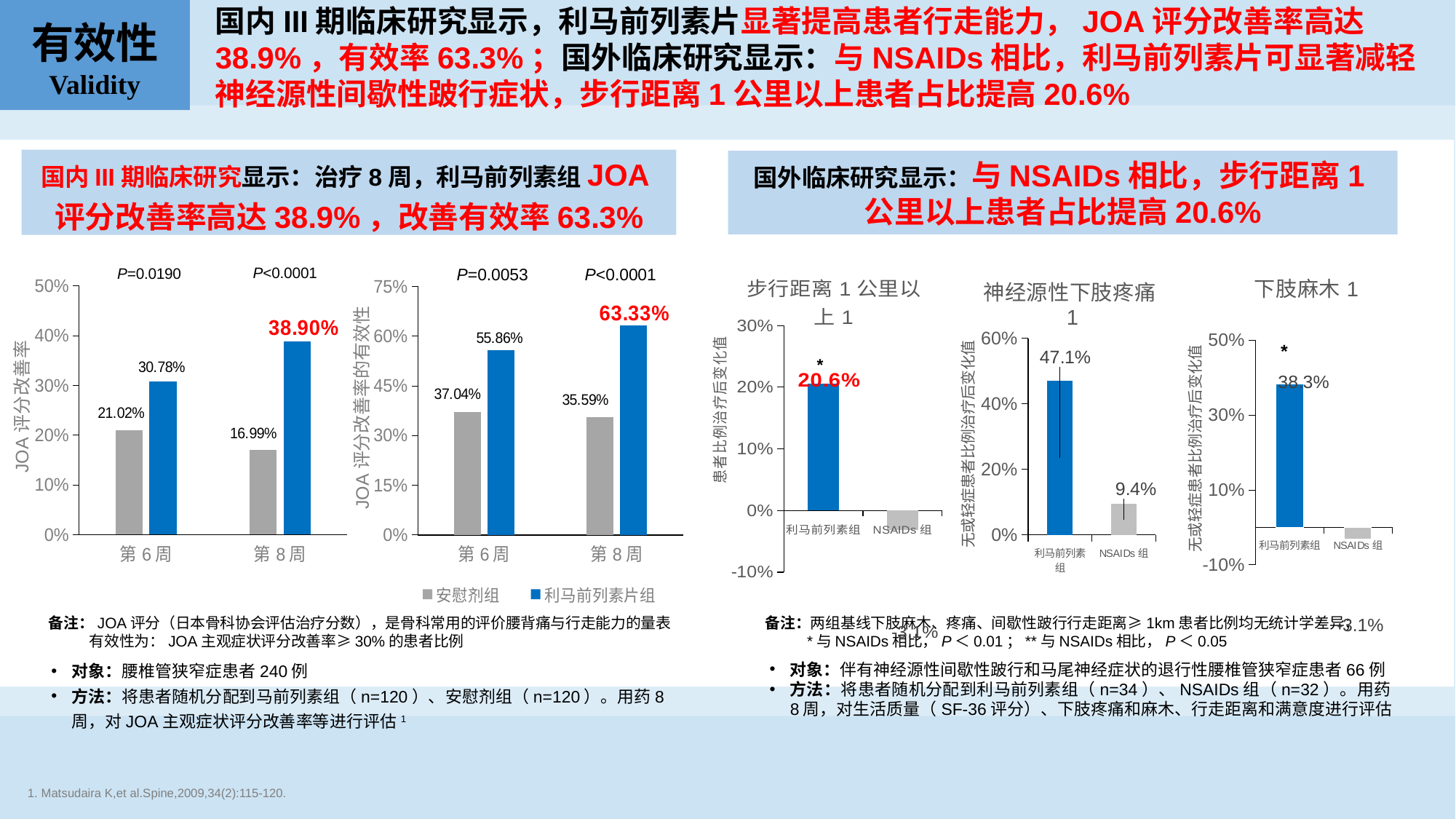
In the chart titled 神经源性下肢疼痛 1, what is the difference between 利马前列素组 and NSAIDs 组? 37.7% In the second chart from the left (JOA 评分改善率的有效性), what is the value for 安慰剂组 at 第 6 周? 37.04% How many series does the legend below the two left charts list? 2 In the chart titled 下肢麻木 1, is the value for 利马前列素组 greater or less than 30%? greater In the leftmost chart (JOA 评分改善率), does the 安慰剂组 value rise or fall from 第 6 周 to 第 8 周? fall In the leftmost chart (JOA 评分改善率), what is the difference between 利马前列素片组 and 安慰剂组 at 第 8 周? 21.91% In the second chart from the left (JOA 评分改善率的有效性), which series has the higher value at 第 6 周? 利马前列素片组 In the leftmost chart (JOA 评分改善率), what is the value for 安慰剂组 at 第 6 周? 21.02% In the leftmost chart (JOA 评分改善率), what is the value for 利马前列素片组 at 第 8 周? 38.90% In the chart titled 步行距离 1 公里以上 1, what is the value for 利马前列素组? 20.6% In the second chart from the left (JOA 评分改善率的有效性), what is the value for 利马前列素片组 at 第 8 周? 63.33% What kind of chart is the chart titled 神经源性下肢疼痛 1? bar chart